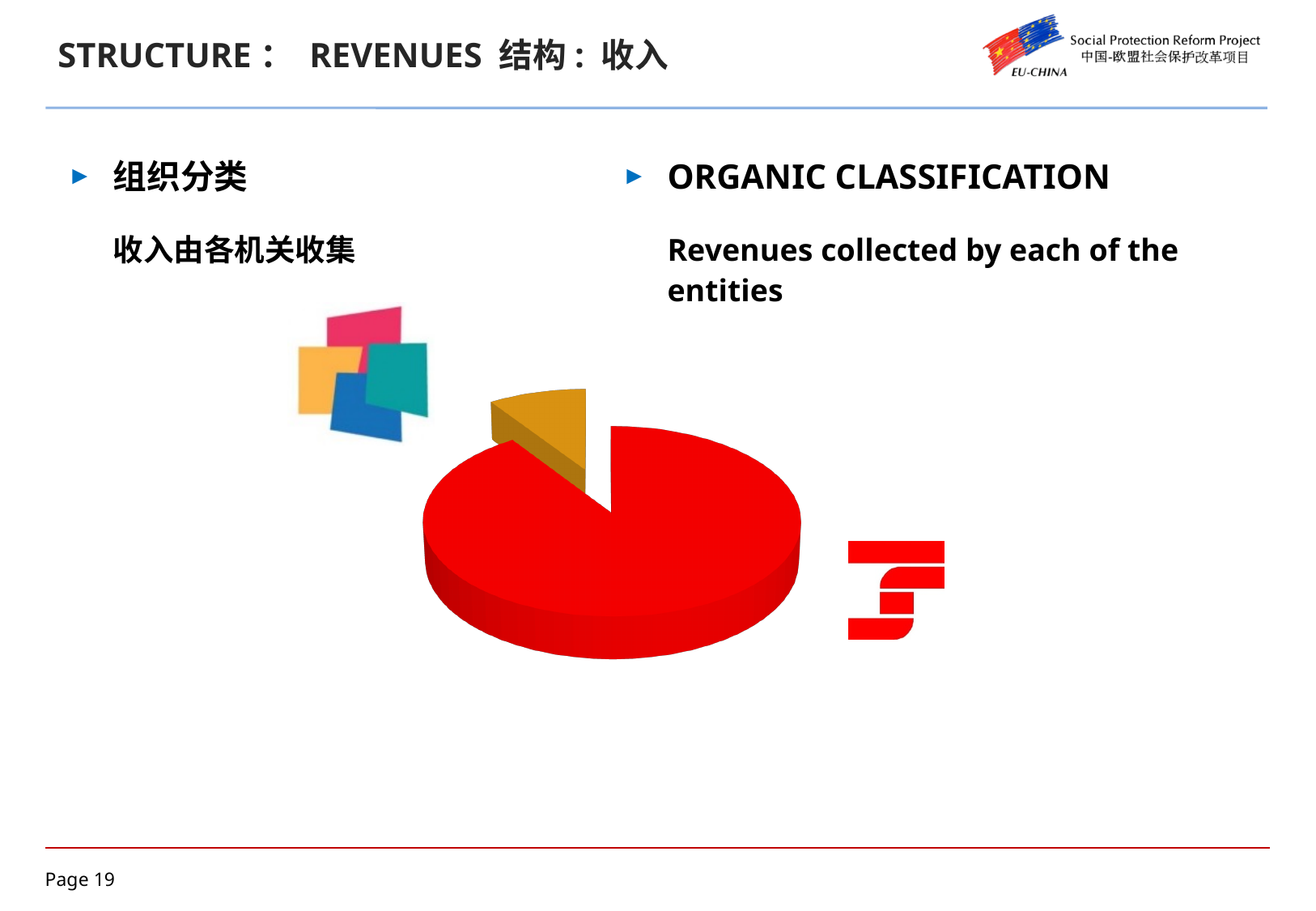
Which slice of the pie chart is pulled out (exploded) from the rest of the pie? the gold slice Which slice of the pie chart is larger, the red slice or the gold slice? the red slice Which slice of the pie chart is the smallest? the gold slice What two colours are used for the slices of the pie chart? red and gold Which slice of the pie chart is the largest? the red slice Is the red slice's share of the pie greater or less than 50%? greater Is the gold slice's share of the pie greater or less than 25%? less What kind of chart is shown on the slide? pie chart How many slices does the pie chart have? 2